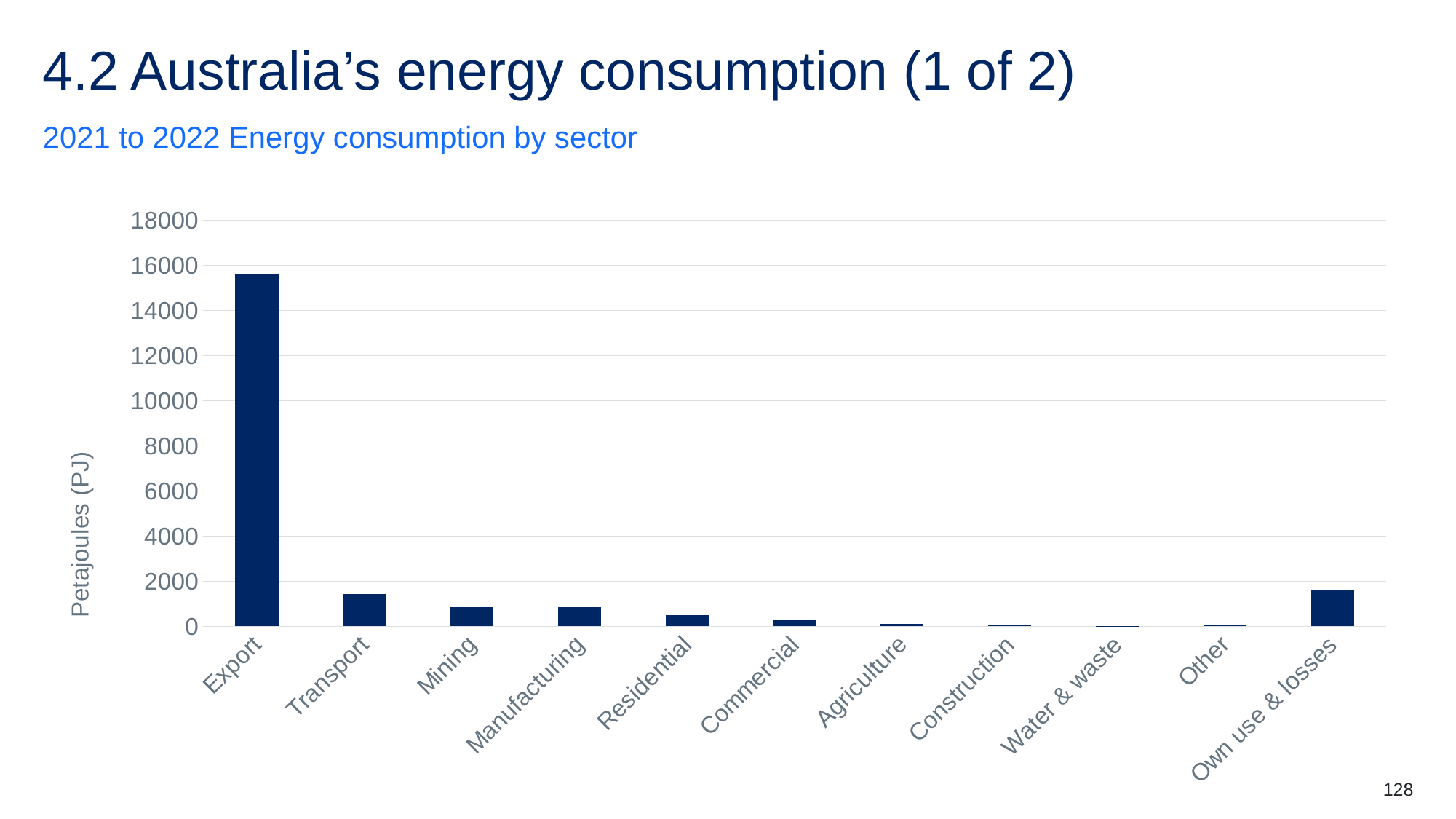
Which is larger, the value for Own use & losses or the value for Mining? Own use & losses Is the value for Export greater or less than 14000? greater Is the value for Transport greater or less than 2000? less Which is larger, the value for Transport or the value for Residential? Transport How many sectors are shown on the x axis of the chart? 11 What is the subtitle describing the chart on the slide? 2021 to 2022 Energy consumption by sector Is the value for Export greater or less than 16000? less Which sector has the highest energy consumption in the chart? Export Which is larger, the value for Export or the value for Transport? Export What kind of chart is shown on the slide? bar chart What is the label on the y axis of the chart? Petajoules (PJ)